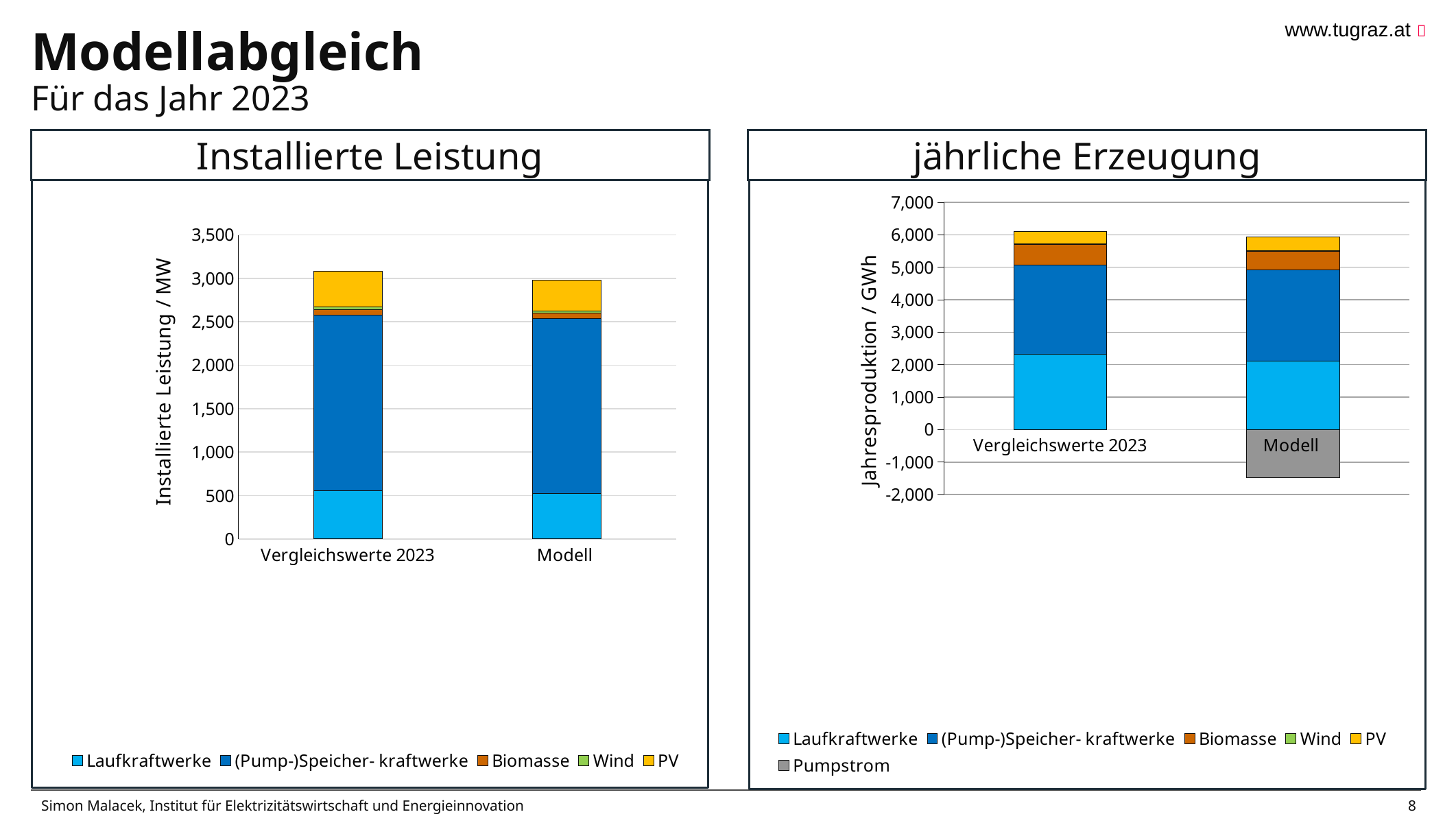
What kind of chart is the "Installierte Leistung" chart? stacked bar chart In the "jährliche Erzeugung" chart, is the Pumpstrom value for Modell greater or less than -1,000? less What is the y-axis label of the "jährliche Erzeugung" chart? Jahresproduktion / GWh How many series does the legend of the "jährliche Erzeugung" chart list? 6 In the "jährliche Erzeugung" chart, which category shows a Pumpstrom segment below zero? Modell In the "Installierte Leistung" chart, is the total stacked value for Vergleichswerte 2023 greater or less than 3,000? greater In the "Installierte Leistung" chart, which category has the higher total stacked value, Vergleichswerte 2023 or Modell? Vergleichswerte 2023 How many series does the legend of the "Installierte Leistung" chart list? 5 How many categories are shown on the x axis of the "Installierte Leistung" chart? 2 In the "jährliche Erzeugung" chart, is the Laufkraftwerke value for Vergleichswerte 2023 greater or less than 2,000? greater